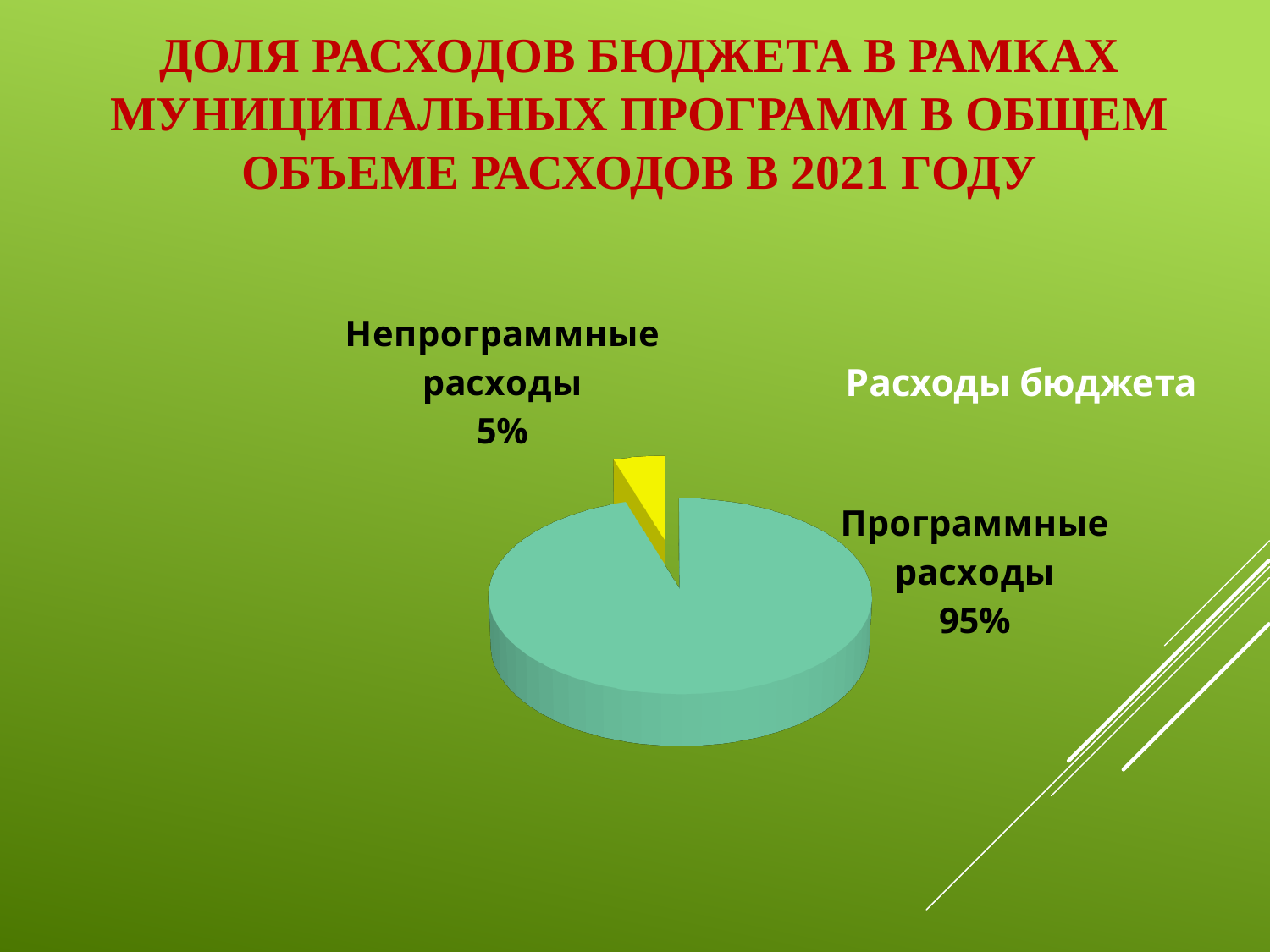
What is the share of Непрограммные расходы in the pie chart? 5% Which slice of the pie chart is the smallest? Непрограммные расходы What is the share of Программные расходы in the pie chart? 95% What is the total of the two slices shown in the pie chart? 100% Which is larger, Программные расходы or Непрограммные расходы? Программные расходы What colour is the slice for Непрограммные расходы? Yellow Which slice of the pie chart is the largest? Программные расходы How many slices does the pie chart have? 2 What kind of chart is shown on the slide? Pie chart What is the title of the pie chart? Расходы бюджета What is the difference in percentage points between Программные расходы and Непрограммные расходы? 90